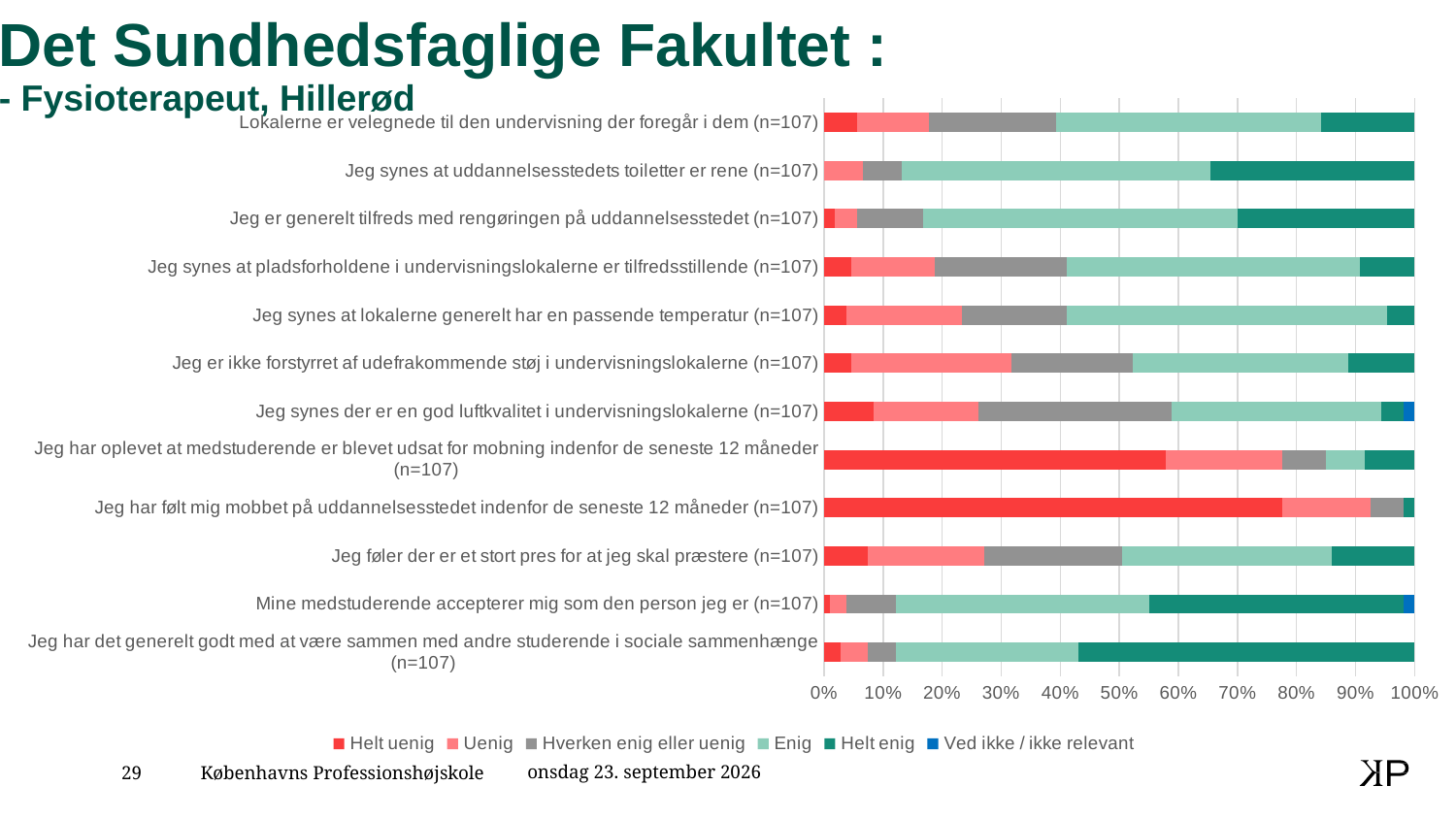
Is the 'Helt uenig' share for 'Jeg har følt mig mobbet på uddannelsesstedet indenfor de seneste 12 måneder' greater or less than 70%? greater What is the number of respondents (n) shown for each statement? 107 Which statement has the largest 'Helt enig' segment? Jeg har det generelt godt med at være sammen med andre studerende i sociale sammenhænge (n=107) Is the 'Helt enig' share for 'Jeg har det generelt godt med at være sammen med andre studerende i sociale sammenhænge' greater or less than 50%? greater Which colour represents 'Ved ikke / ikke relevant' in the legend? Blue Which has the larger 'Helt uenig' share: 'Jeg har følt mig mobbet på uddannelsesstedet indenfor de seneste 12 måneder' or 'Jeg har oplevet at medstuderende er blevet udsat for mobning indenfor de seneste 12 måneder'? Jeg har følt mig mobbet på uddannelsesstedet indenfor de seneste 12 måneder Which statement has the largest 'Helt uenig' segment? Jeg har følt mig mobbet på uddannelsesstedet indenfor de seneste 12 måneder (n=107) What kind of chart is shown on the slide? Stacked bar chart What does each stacked bar add up to on the x axis? 100% How many series does the legend list? 6 How many statements (categories) are plotted in the chart? 12 Is the 'Helt uenig' share for 'Jeg har oplevet at medstuderende er blevet udsat for mobning indenfor de seneste 12 måneder' greater or less than 50%? greater